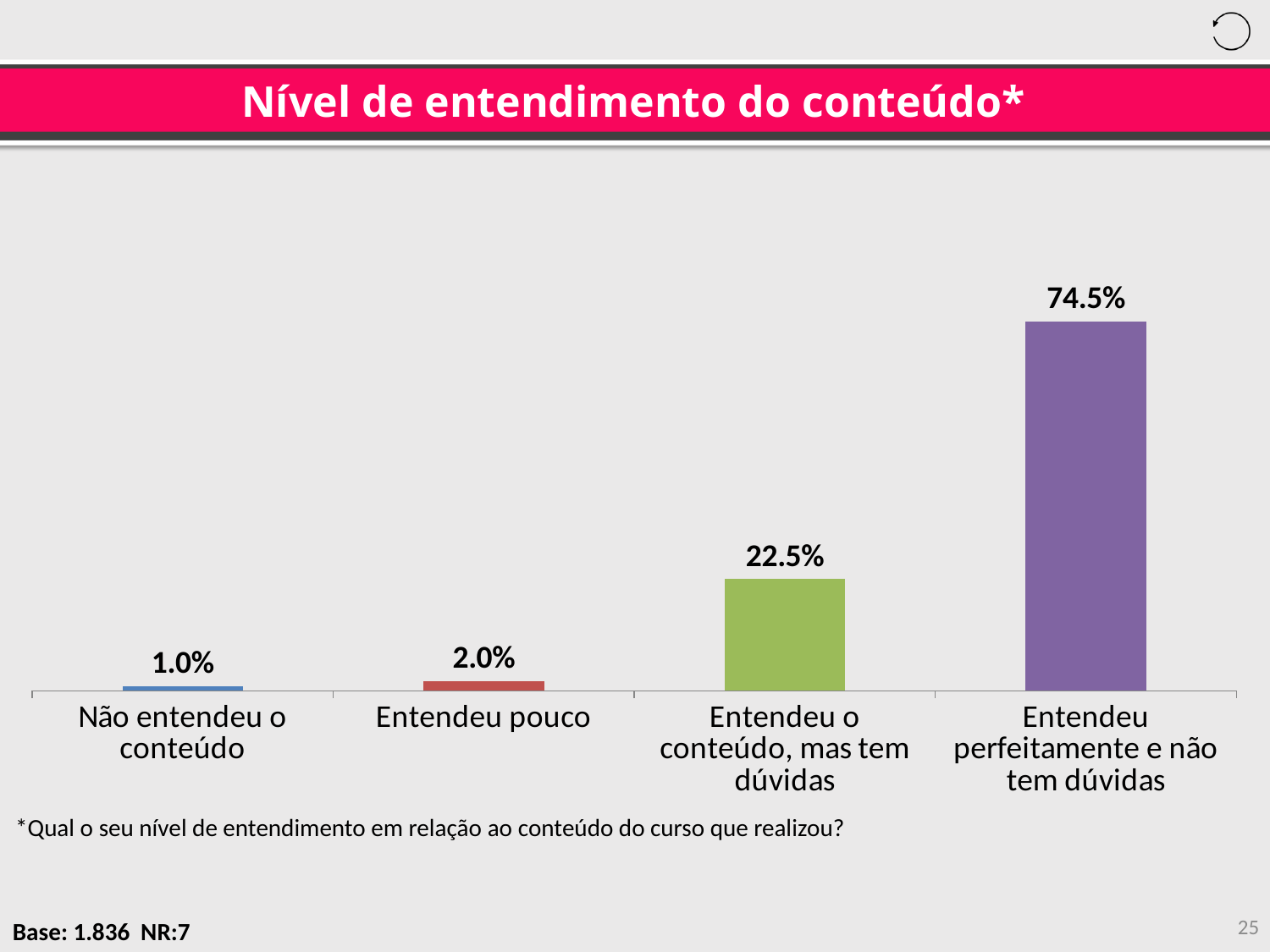
Which category has the lowest value? Não entendeu o conteúdo What is the value for "Entendeu pouco"? 2.0% What kind of chart is shown on the slide? Bar chart What is the value for "Entendeu o conteúdo, mas tem dúvidas"? 22.5% Which category has the highest value? Entendeu perfeitamente e não tem dúvidas How many categories are shown in the chart? 4 Which is larger, the value for "Entendeu o conteúdo, mas tem dúvidas" or the value for "Entendeu pouco"? Entendeu o conteúdo, mas tem dúvidas What is the value for "Não entendeu o conteúdo"? 1.0% What is the title of the chart? Nível de entendimento do conteúdo* What is the difference between the values for "Entendeu pouco" and "Não entendeu o conteúdo"? 1.0% What is the difference between the values for "Entendeu perfeitamente e não tem dúvidas" and "Entendeu o conteúdo, mas tem dúvidas"? 52.0% What is the value for "Entendeu perfeitamente e não tem dúvidas"? 74.5%